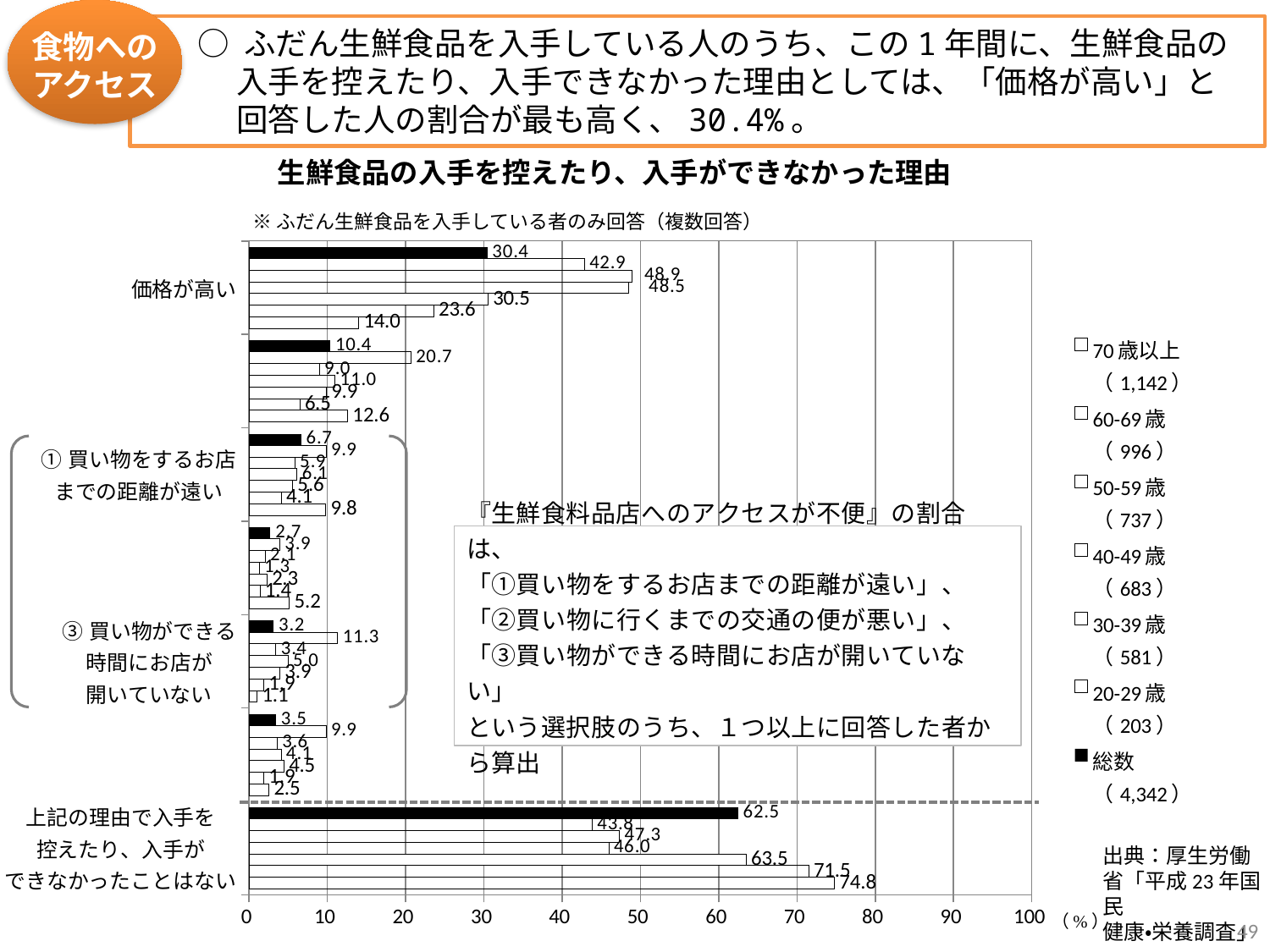
What is the 総数 (black bar) value for 価格が高い? 30.4 What is the difference between the 総数 values for 上記の理由で入手を控えたり、入手ができなかったことはない and 価格が高い? 32.1 What is the sample size shown in the legend for 総数? 4,342 What is the 総数 (black bar) value for ③買い物ができる時間にお店が開いていない? 3.2 What is the 総数 (black bar) value for 上記の理由で入手を控えたり、入手ができなかったことはない? 62.5 What is the highest value printed in the 価格が高い group of bars? 48.9 What is the 総数 (black bar) value for ①買い物をするお店までの距離が遠い? 6.7 What kind of chart is shown on the slide? bar chart Among the reasons listed (excluding the bottom 'ことはない' category), which has the highest 総数 value? 価格が高い Which has the larger 総数 value: 価格が高い or ①買い物をするお店までの距離が遠い? 価格が高い What is the title of the chart? 生鮮食品の入手を控えたり、入手ができなかった理由 How many series does the legend list? 7